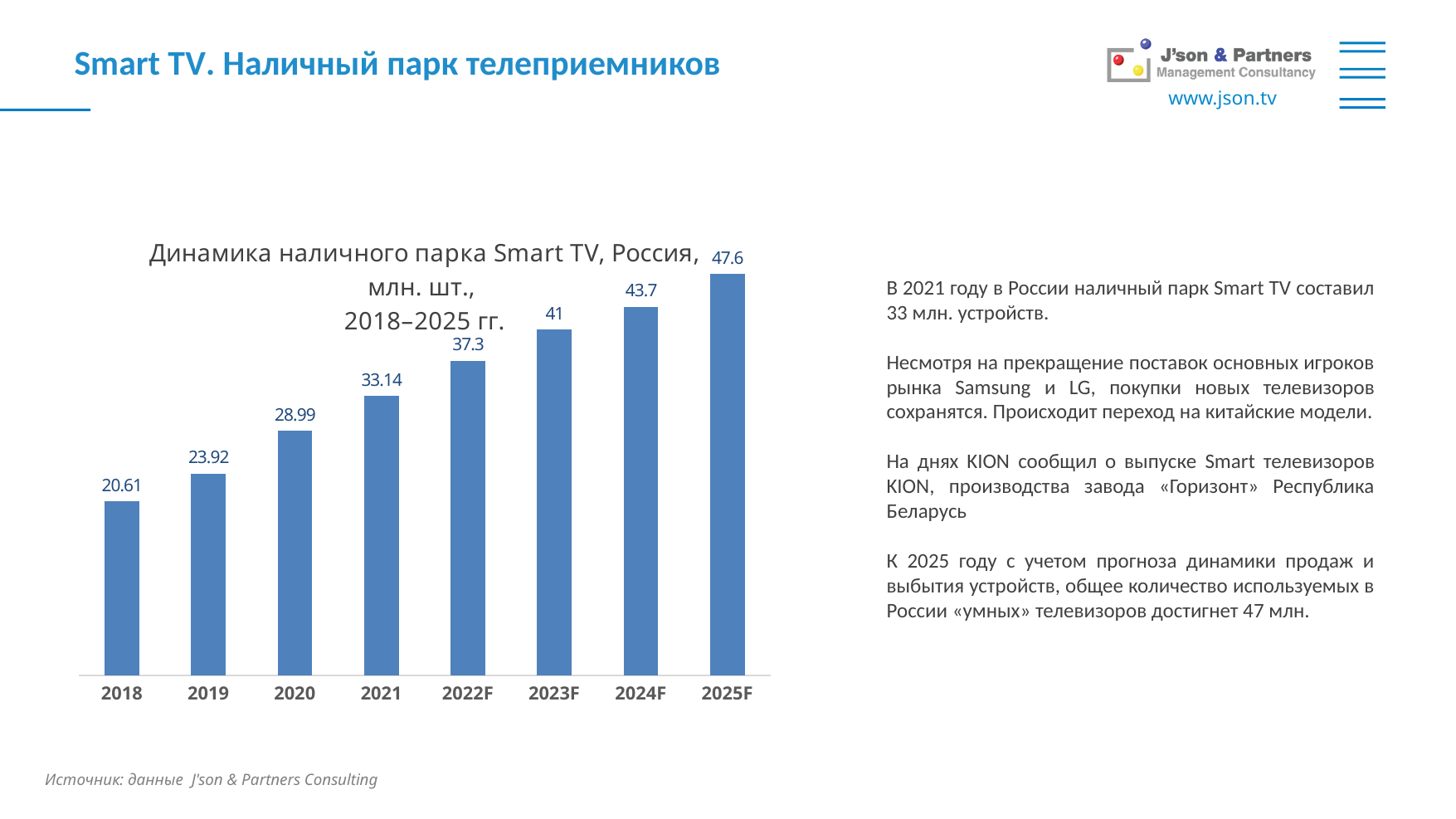
Which year has the highest value? 2025F What is the value for 2018? 20.61 Which year has the lowest value? 2018 What is the difference between the values for 2020 and 2019? 5.07 What is the value for 2021? 33.14 How many years are shown on the x axis? 8 What is the title of the chart? Динамика наличного парка Smart TV, Россия, млн. шт., 2018–2025 гг. Which is larger, the value for 2022F or the value for 2023F? 2023F What kind of chart is this? bar chart What is the value for 2024F? 43.7 Do the values rise or fall from 2018 to 2025F? rise What is the difference between the values for 2025F and 2018? 26.99